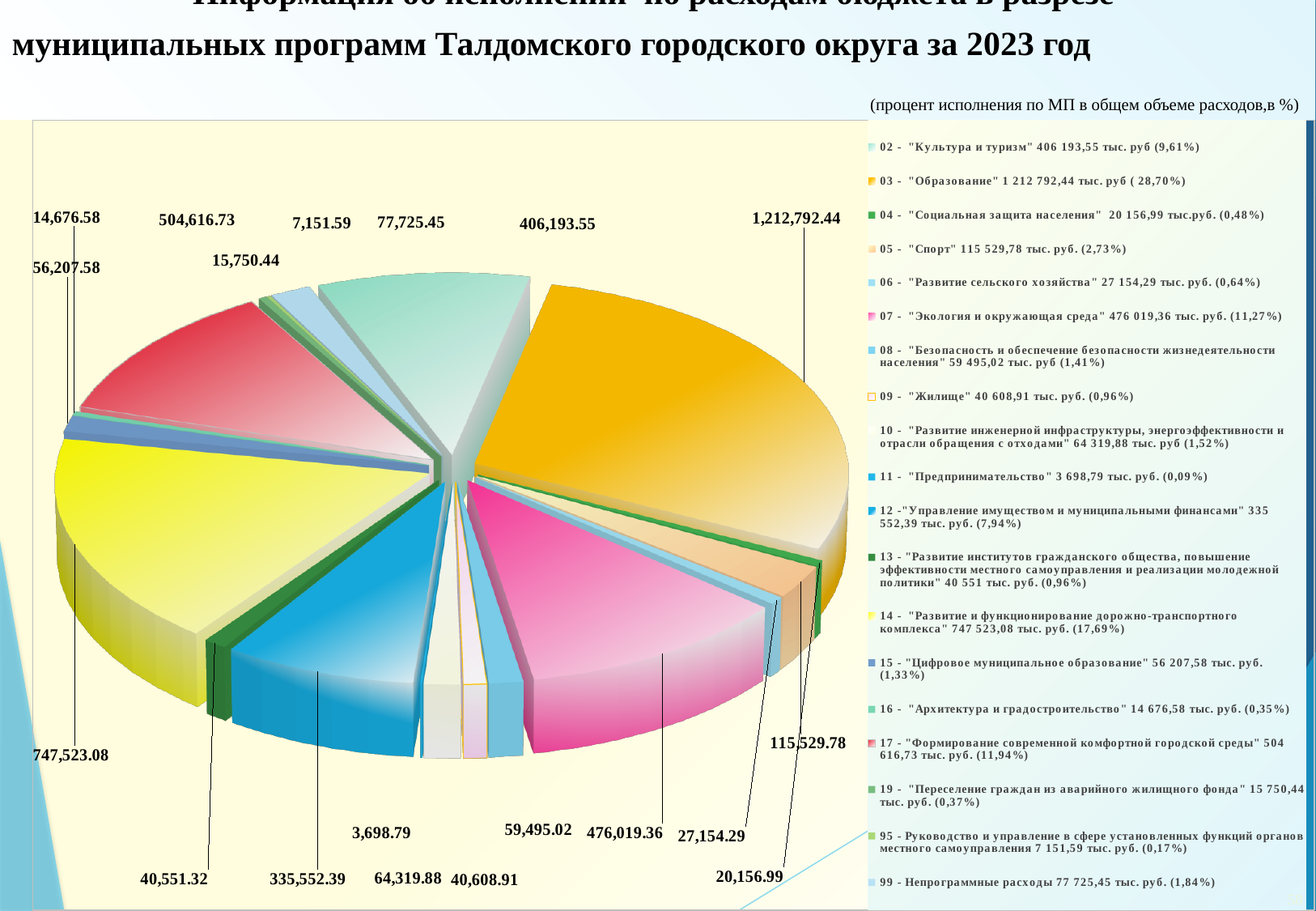
What is the value shown for "Культура и туризм" (02)? 406,193.55 Which is larger: the value for "Экология и окружающая среда" (07) or for "Формирование современной комфортной городской среды" (17)? "Формирование современной комфортной городской среды" (17) What is the name of legend entry 99? Непрограммные расходы What share of total expenditure does "Образование" (03) account for, according to the legend? 28,70% What is the value shown for "Развитие и функционирование дорожно-транспортного комплекса" (14)? 747,523.08 Which municipal program has the smallest slice of the pie? 11 - "Предпринимательство" What share of total expenditure does "Экология и окружающая среда" (07) account for, according to the legend? 11,27% What kind of chart is shown on the slide? pie chart Which municipal program has the largest slice of the pie? 03 - "Образование" What is the value shown for "Спорт" (05)? 115,529.78 How many slices (programs) does the pie chart contain? 19 What is the difference between the value for "Образование" (1,212,792.44) and the value for "Развитие и функционирование дорожно-транспортного комплекса" (747,523.08)? 465,269.36